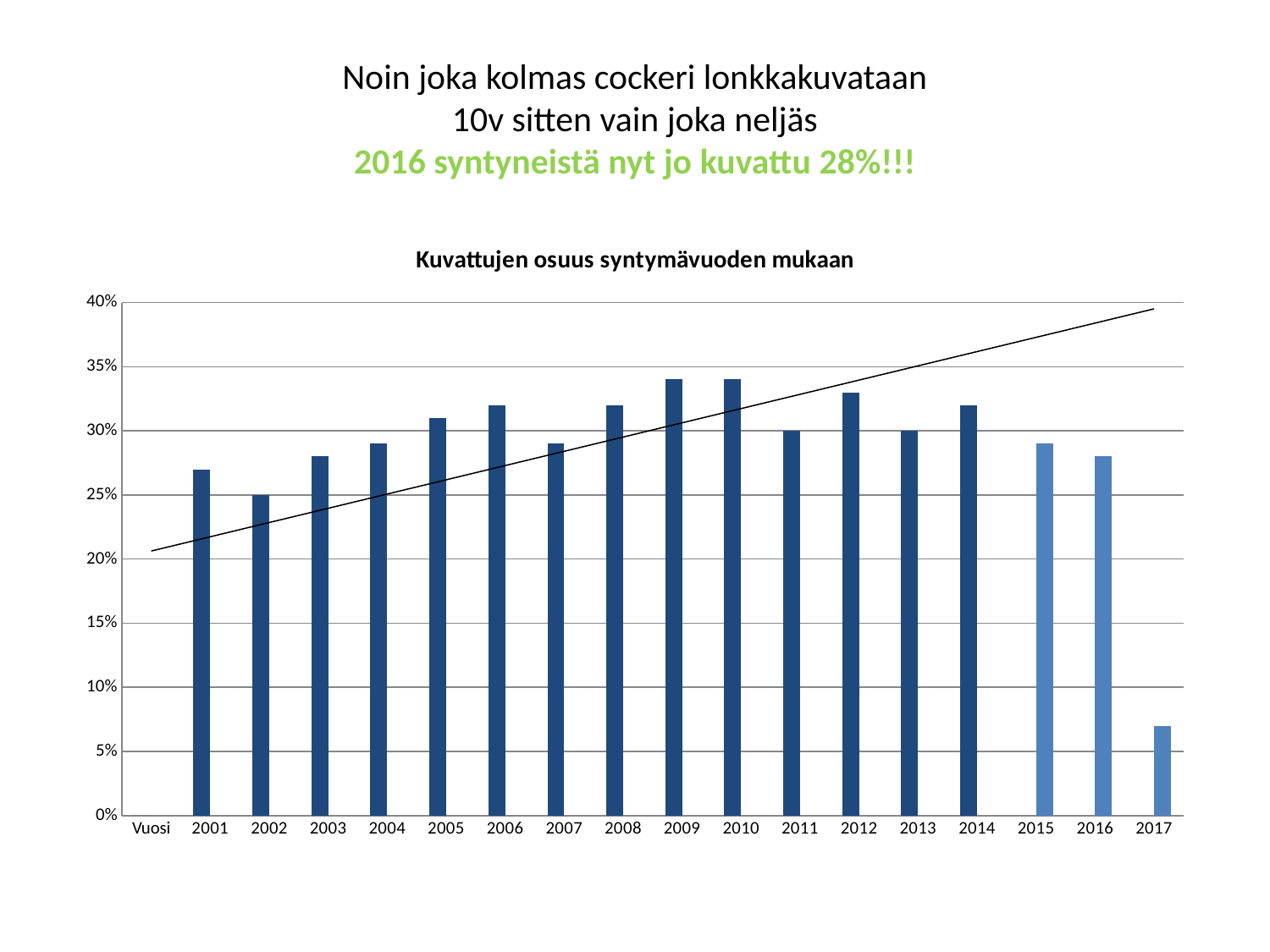
What is the title of the chart? Kuvattujen osuus syntymävuoden mukaan Which year has the lowest value? 2017 How many years have bars in the chart? 17 What is the value for 2002? 25% What is the value for 2013? 30% Is the value for 2009 greater or less than 30%? greater Which is larger, the value for 2009 or the value for 2002? 2009 Do the values generally rise or fall from 2001 to 2009? rise Is the value for 2001 greater or less than 25%? greater What type of chart is shown on the slide? bar chart What is the value for 2011? 30% Is the value for 2017 greater or less than 10%? less